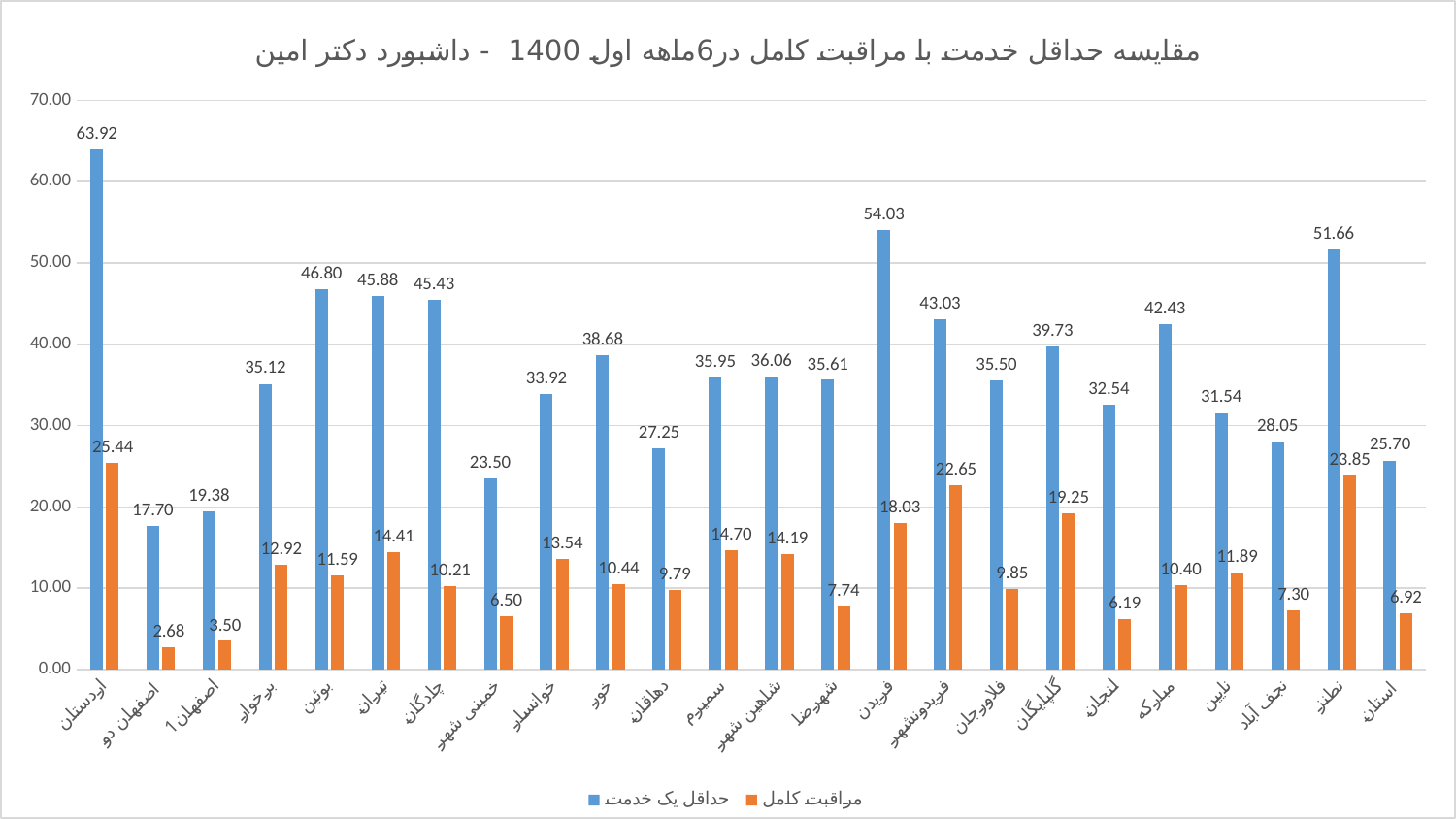
What is the difference between حداقل یک خدمت and مراقبت کامل for فریدن? 36.00 How many series does the legend list? 2 What kind of chart is shown on the slide? bar chart Is the value of حداقل یک خدمت for نطنز greater or less than 50.00? greater How many categories are shown on the x axis? 24 Which category has the highest value for حداقل یک خدمت? اردستان Which category has the lowest value for مراقبت کامل? اصفهان دو What is the value of حداقل یک خدمت for اردستان? 63.92 What is the value of مراقبت کامل for فریدونشهر? 22.65 Which is larger: the حداقل یک خدمت value for بوئین or for تیران? بوئین Which colour represents the مراقبت کامل series? orange What is the value of مراقبت کامل for نطنز? 23.85